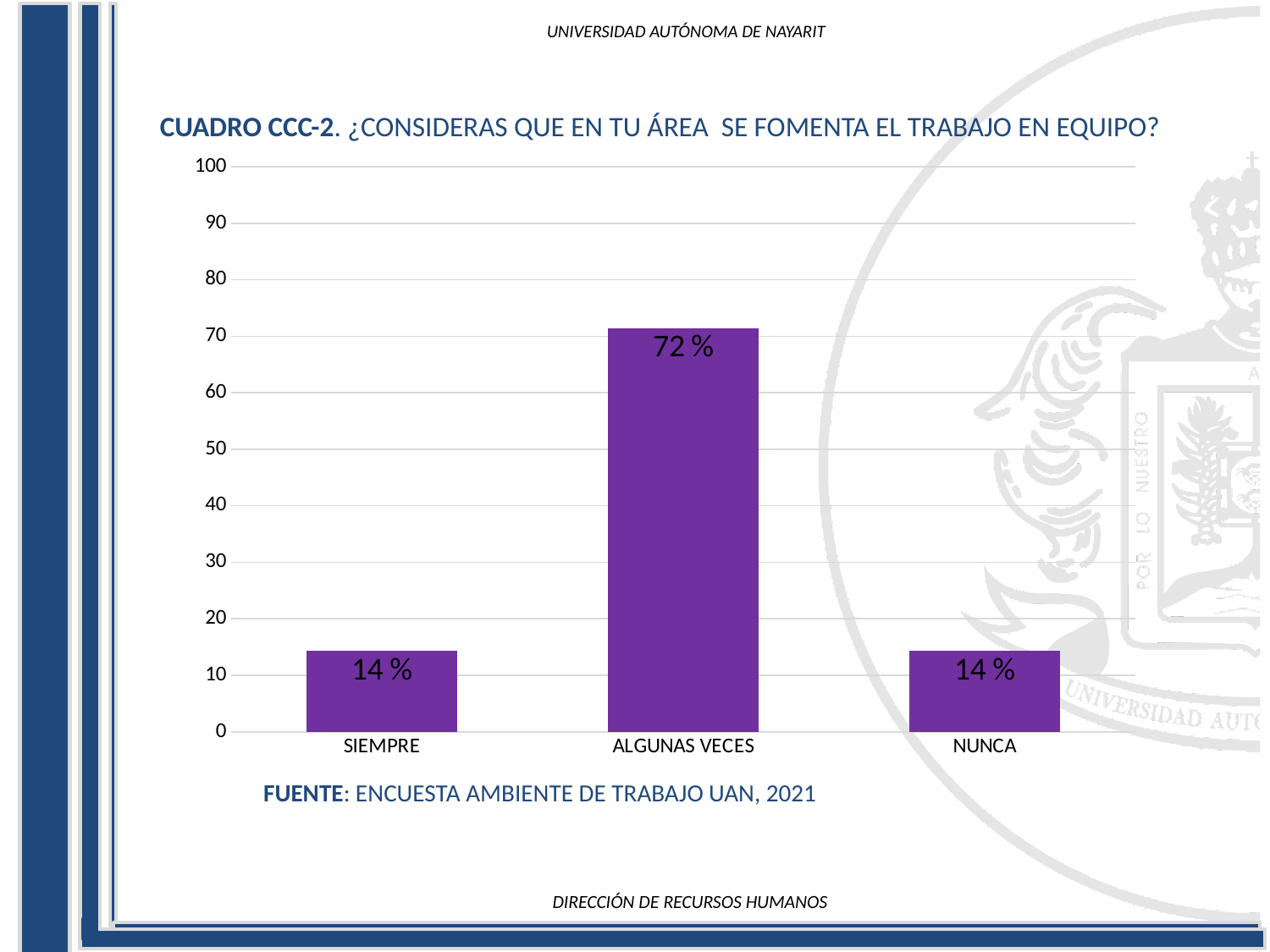
What is the value for NUNCA? 14 % Which is larger, the value for ALGUNAS VECES or the value for NUNCA? ALGUNAS VECES Which category has the highest value? ALGUNAS VECES Is the value for SIEMPRE larger than, smaller than, or equal to the value for NUNCA? equal Is the value for SIEMPRE greater or less than 20? less What is the difference between the values for ALGUNAS VECES and SIEMPRE? 58 % What kind of chart is shown on the slide? bar chart Is the value for ALGUNAS VECES greater or less than 50? greater What is the value for SIEMPRE? 14 % What source is cited below the chart? ENCUESTA AMBIENTE DE TRABAJO UAN, 2021 What is the value for ALGUNAS VECES? 72 % How many categories are shown on the x axis? 3